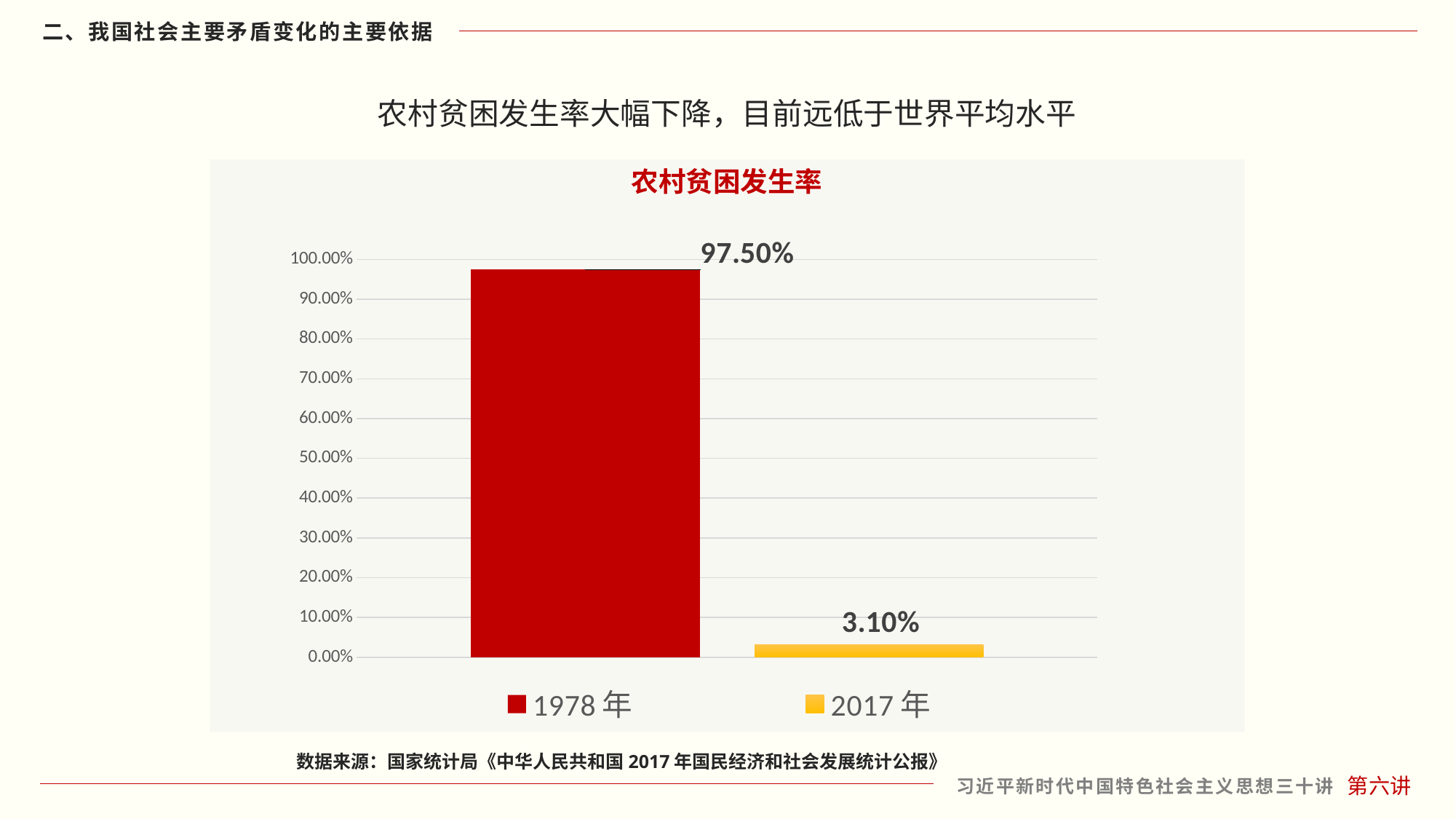
What is the rural poverty incidence rate for 1978 年 in the 农村贫困发生率 chart? 97.50% Which year has the higher rural poverty incidence rate in the chart? 1978 年 How many bars are plotted in the chart? 2 Is the value for 1978 年 larger or smaller than the value for 2017 年? larger Is the value for 2017 年 greater or less than 10.00%? less What is the rural poverty incidence rate for 2017 年 in the 农村贫困发生率 chart? 3.10% How many entries does the legend list? 2 Is the value for 1978 年 greater or less than 90.00%? greater By how many percentage points did the rural poverty incidence rate fall from 1978 年 to 2017 年? 94.40% What kind of chart is shown on the slide? bar chart What is the title of the chart? 农村贫困发生率 Which year has the lower rural poverty incidence rate in the chart? 2017 年